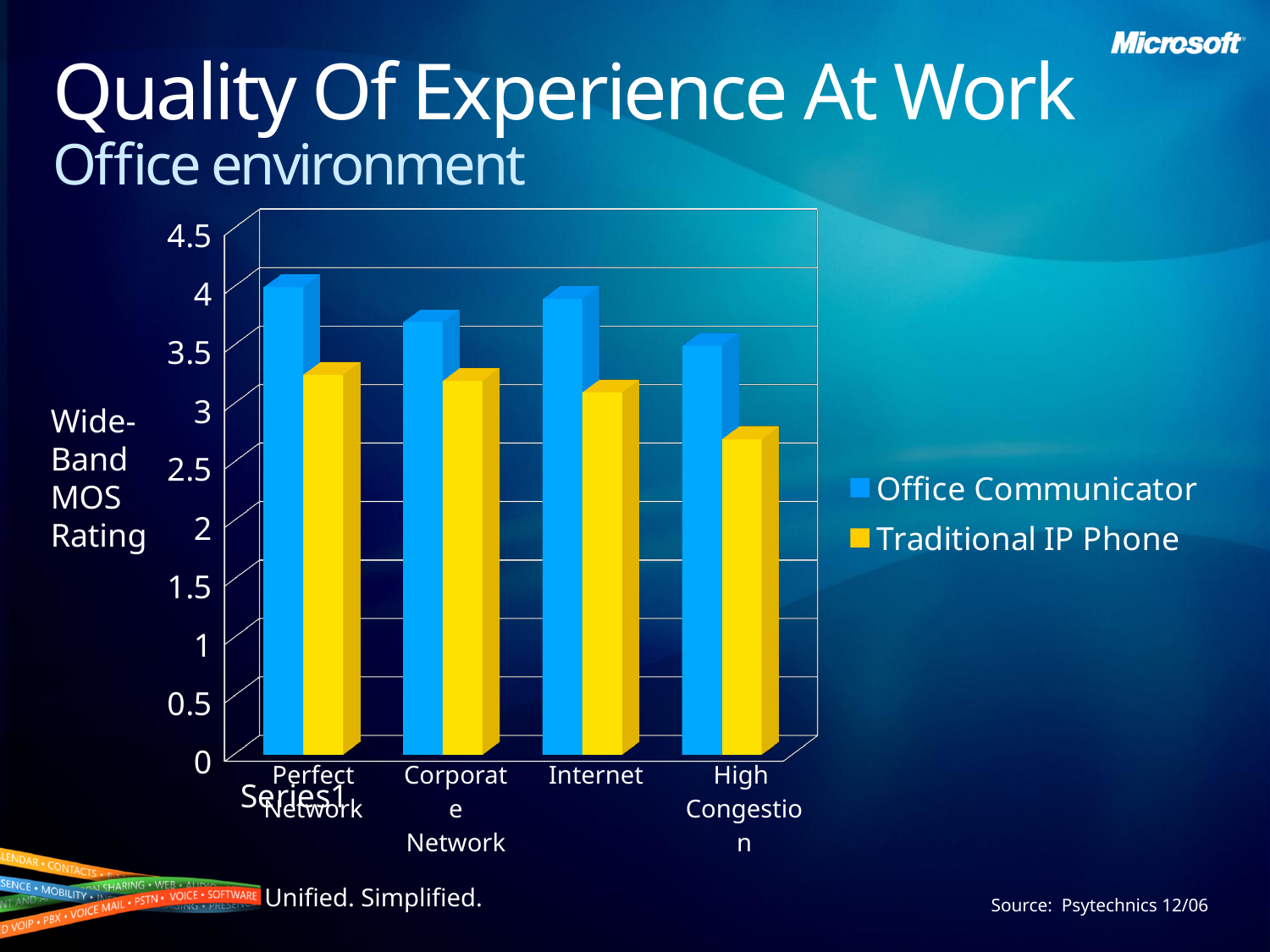
Is the Office Communicator value for Perfect Network greater or less than 3.5? greater Is the Traditional IP Phone value for High Congestion greater or less than 3? less For High Congestion, which series has the higher rating, Office Communicator or Traditional IP Phone? Office Communicator Which series is shown in blue in the chart? Office Communicator How many series does the chart legend list? 2 For which category is the Office Communicator rating lowest? High Congestion Is the Office Communicator value for High Congestion greater or less than 3? greater How many network categories are shown on the x axis of the chart? 4 What is the label on the vertical axis of the chart? Wide-Band MOS Rating For which category is the Traditional IP Phone rating lowest? High Congestion What kind of chart is shown on the slide? bar chart